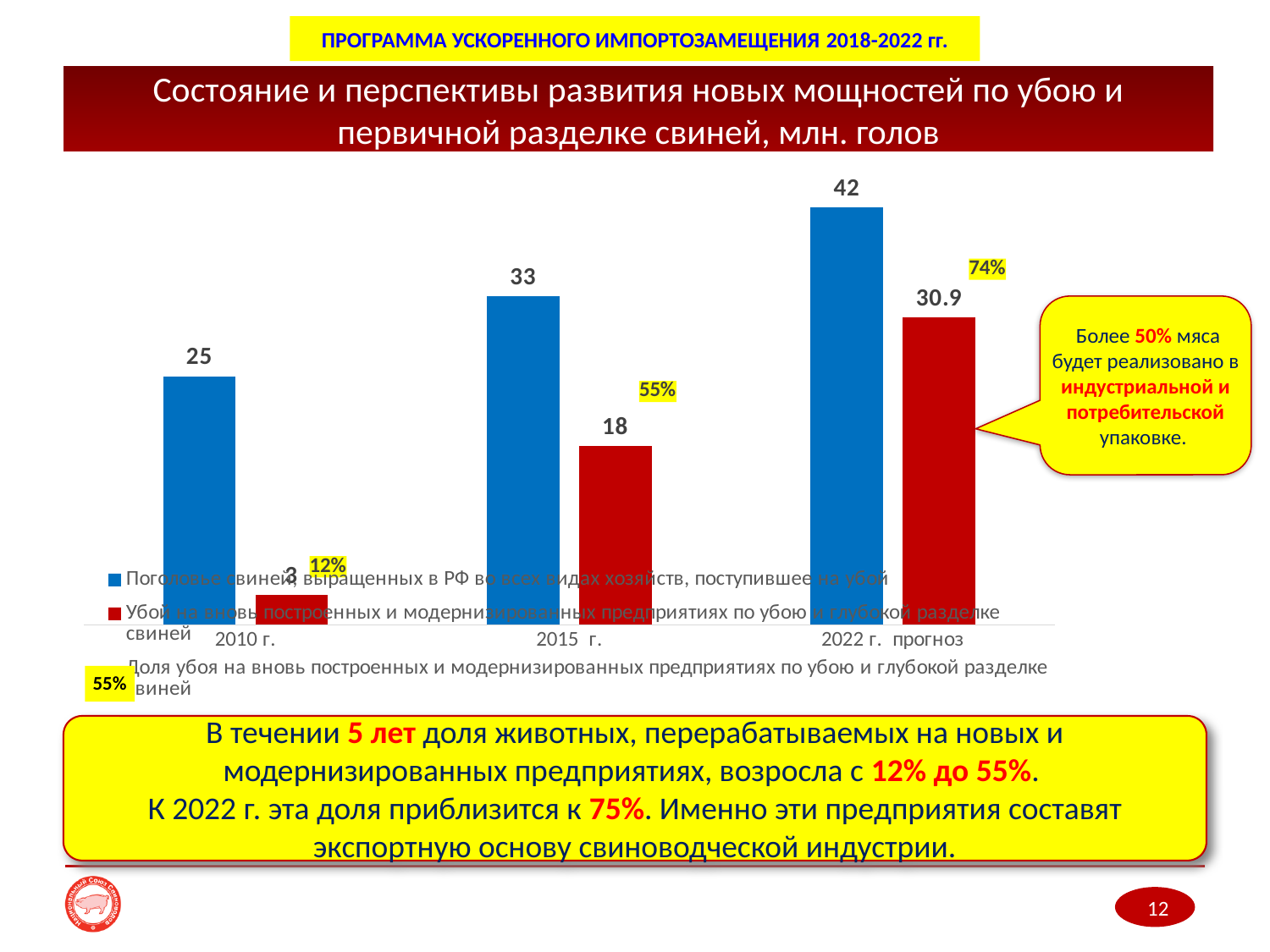
What is the value of the blue series for 2010 г.? 25 What is the value of the blue series (Поголовье свиней, выращенных в РФ во всех видах хозяйств, поступившее на убой) for 2022 г. прогноз? 42 Which is larger: the blue value for 2015 г. or the red value for 2022 г. прогноз? The blue value for 2015 г. (33) What type of chart is shown on the slide? Bar chart What is the value of the red series (Убой на вновь построенных и модернизированных предприятиях) for 2015 г.? 18 What is the difference between the blue and red values for 2015 г.? 15 In which year does the blue series reach its highest value? 2022 г. прогноз In which year is the red series at its lowest? 2010 г. By how much does the blue series value for 2022 г. прогноз exceed its value for 2015 г.? 9 Does the blue series rise or fall from 2010 г. to 2022 г. прогноз? Rises What is the value of the red series for 2022 г. прогноз? 30.9 How many year categories are shown on the x axis? 3